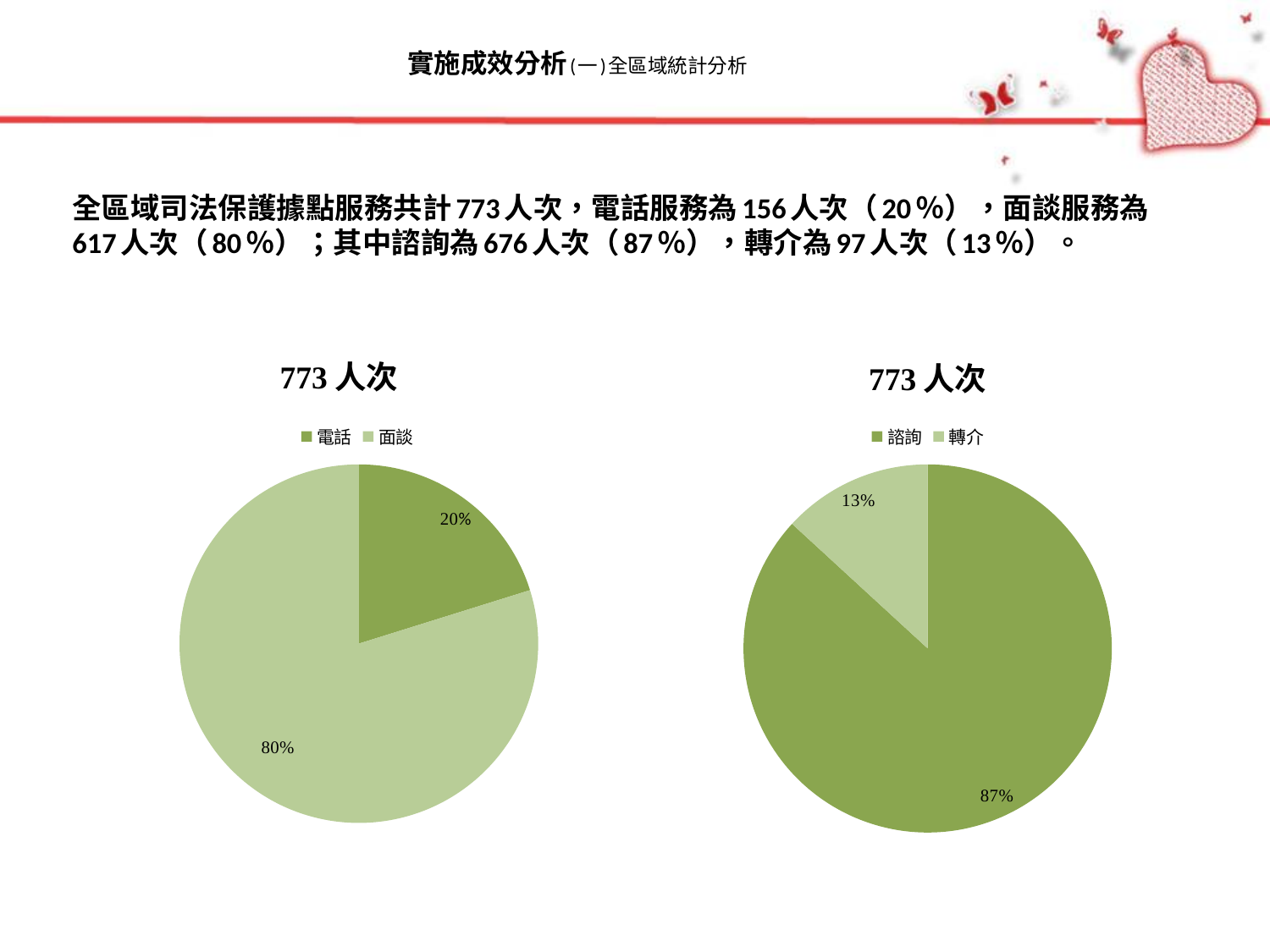
In the left pie chart, which category has the largest slice? 面談 In the right pie chart, what is the difference in percentage points between 諮詢 and 轉介? 74 In the right pie chart, what share does 諮詢 have? 87% How many slices does the right pie chart have? 2 In the left pie chart, what is the difference in percentage points between 面談 and 電話? 60 In the right pie chart, which category has the smallest slice? 轉介 What is the title of the right pie chart? 773 人次 What kind of chart is the left chart on the slide? pie chart In the right pie chart, what share does 轉介 have? 13% In the left pie chart, what share does 面談 have? 80% How many entries does the legend of the left pie chart list? 2